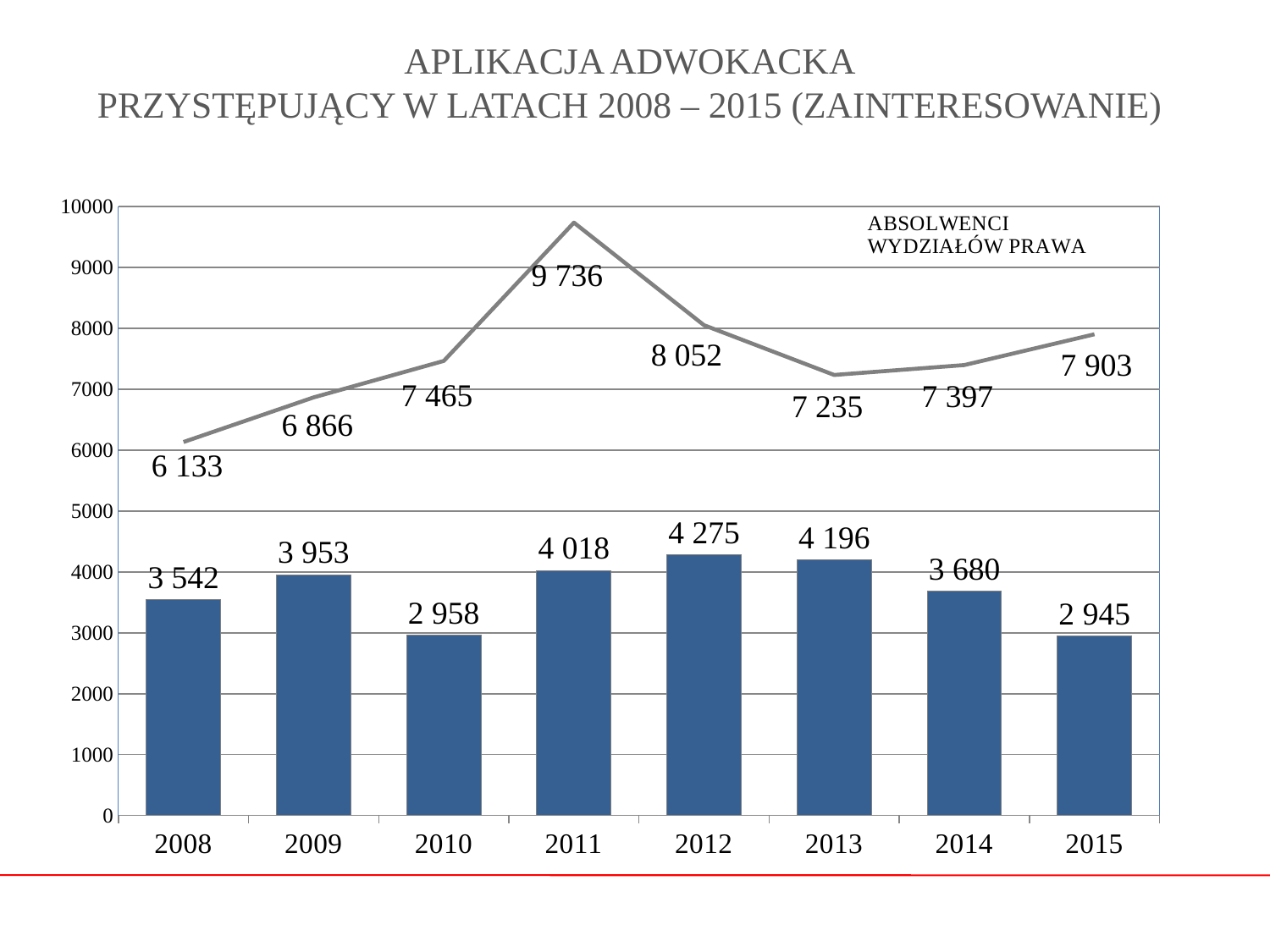
How many years are shown on the x axis? 8 Which year has the highest bar value? 2012 Does the ABSOLWENCI WYDZIAŁÓW PRAWA line rise or fall from 2008 to 2011? rise What is the value of the bar for 2010? 2 958 Which year has the lowest bar value? 2015 In which year does the ABSOLWENCI WYDZIAŁÓW PRAWA line reach its highest value? 2011 What is the value of the bar for 2012? 4 275 By how much does the ABSOLWENCI WYDZIAŁÓW PRAWA line value for 2011 exceed the value for 2010? 2 271 What is the difference between the bar values for 2012 and 2011? 257 Which year has the larger bar value, 2009 or 2014? 2009 In which year does the ABSOLWENCI WYDZIAŁÓW PRAWA line have its lowest value? 2008 What is the value of the ABSOLWENCI WYDZIAŁÓW PRAWA line for 2011? 9 736